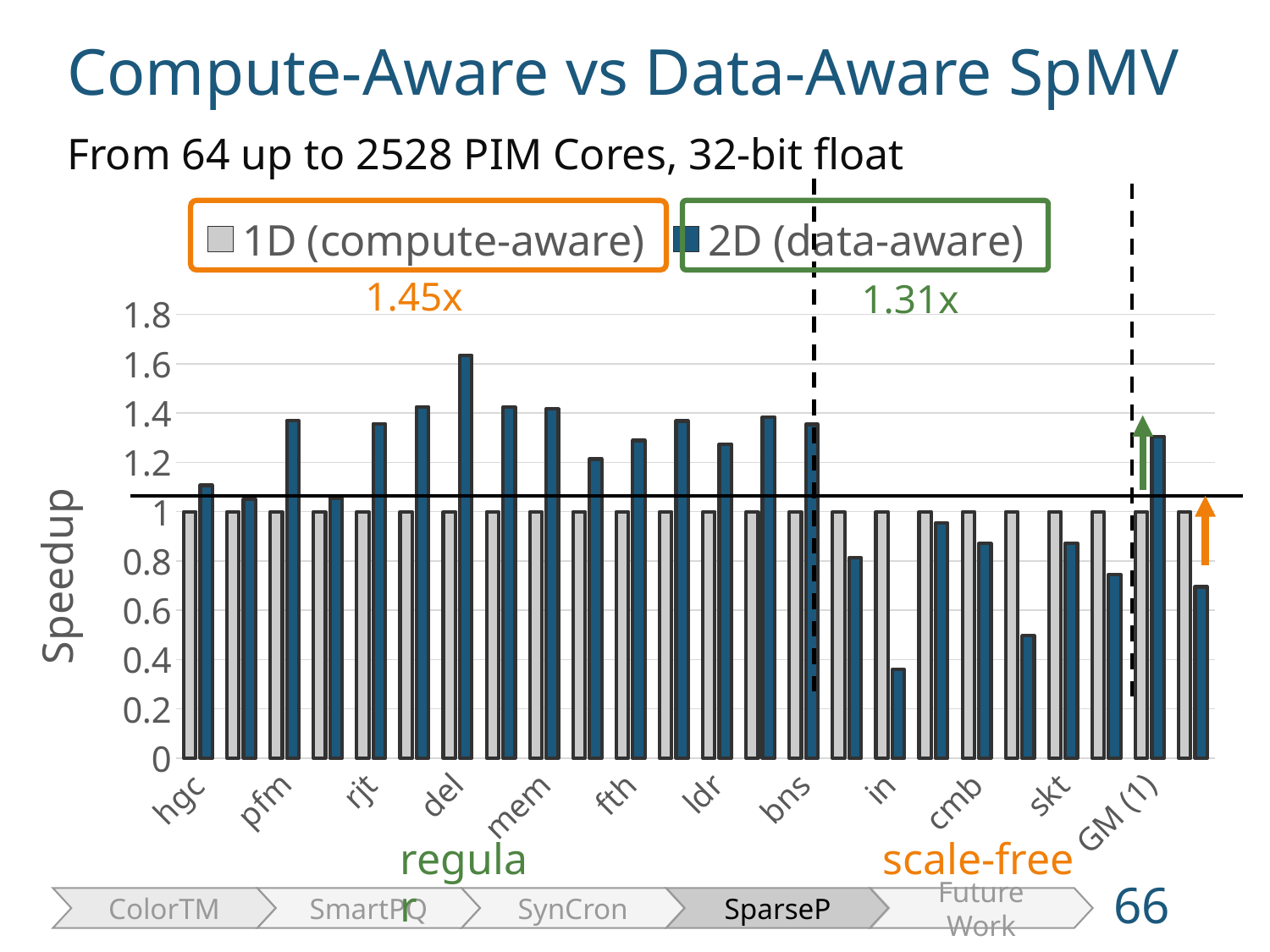
How many series does the legend list? 2 What is the label of the y axis? Speedup Is the 2D (data-aware) value for del greater or less than 1.4? greater Among the labeled categories, which has the highest 2D (data-aware) speedup? del What is the 1D (compute-aware) speedup value for hgc? 1 Is the 2D (data-aware) value for GM (1) greater or less than 1.2? greater What kind of chart is shown on the slide? bar chart What are the two series named in the legend? 1D (compute-aware) and 2D (data-aware) Which has the larger 2D (data-aware) speedup, skt or GM (1)? GM (1) What is the 1D (compute-aware) speedup value for skt? 1 Which has the larger 2D (data-aware) speedup, hgc or del? del Is the 2D (data-aware) value for in greater or less than 1? less